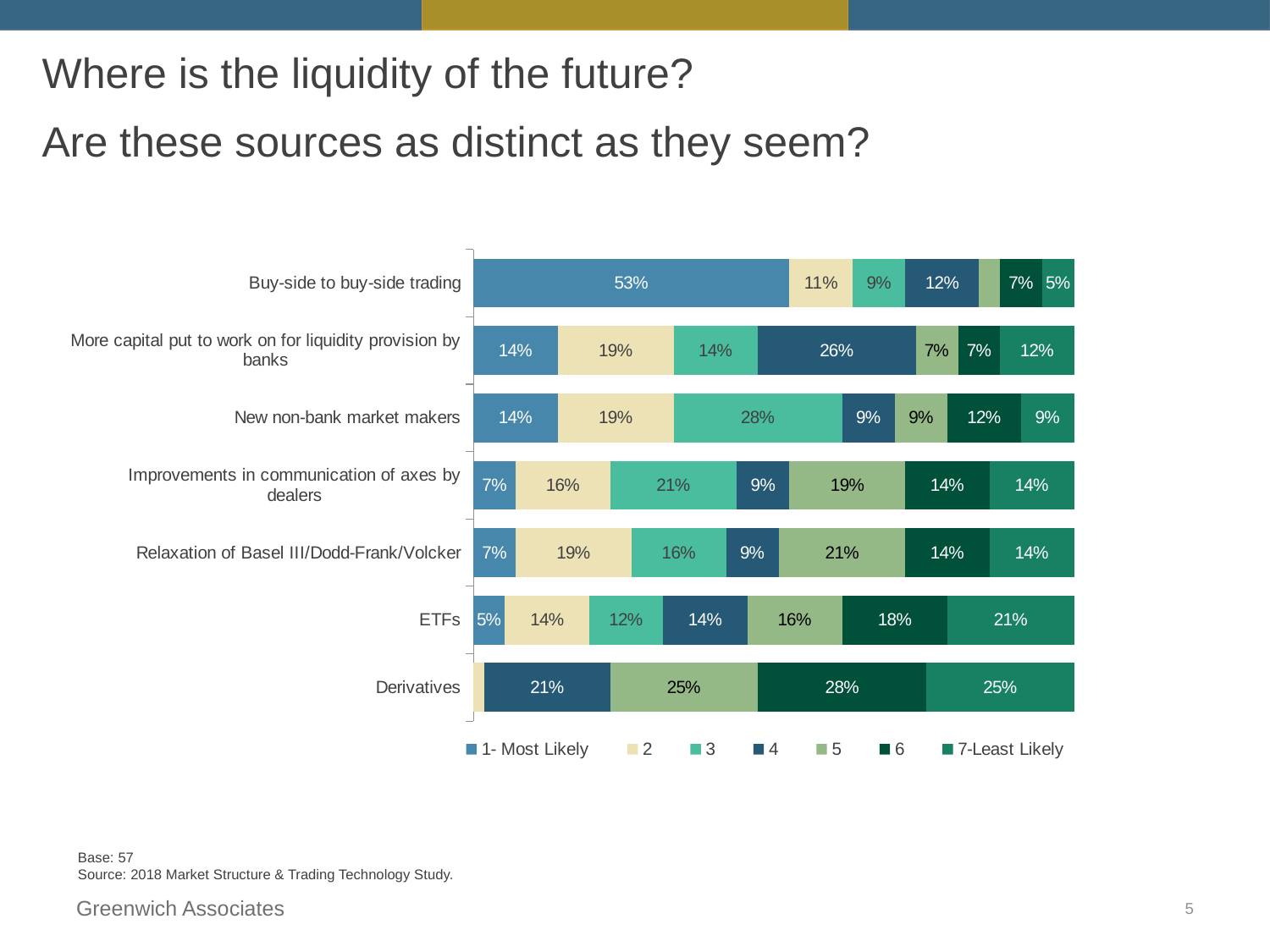
How many categories (liquidity sources) are shown on the chart? 7 What is the first entry in the chart's legend? 1- Most Likely What type of chart is shown on the slide? Stacked bar chart Which category has the highest 1- Most Likely share? Buy-side to buy-side trading How many series does the legend list? 7 Which category has the largest 7-Least Likely segment? Derivatives What percentage of respondents rated Buy-side to buy-side trading as 1- Most Likely? 53% Which has a larger '6' value: ETFs or Relaxation of Basel III/Dodd-Frank/Volcker? ETFs What is the 7-Least Likely value for ETFs? 21% What is the value of the '6' segment for Derivatives? 28% What is the '3' value for New non-bank market makers? 28% What is the difference between the '4' value for More capital put to work on for liquidity provision by banks and the '4' value for New non-bank market makers? 17%